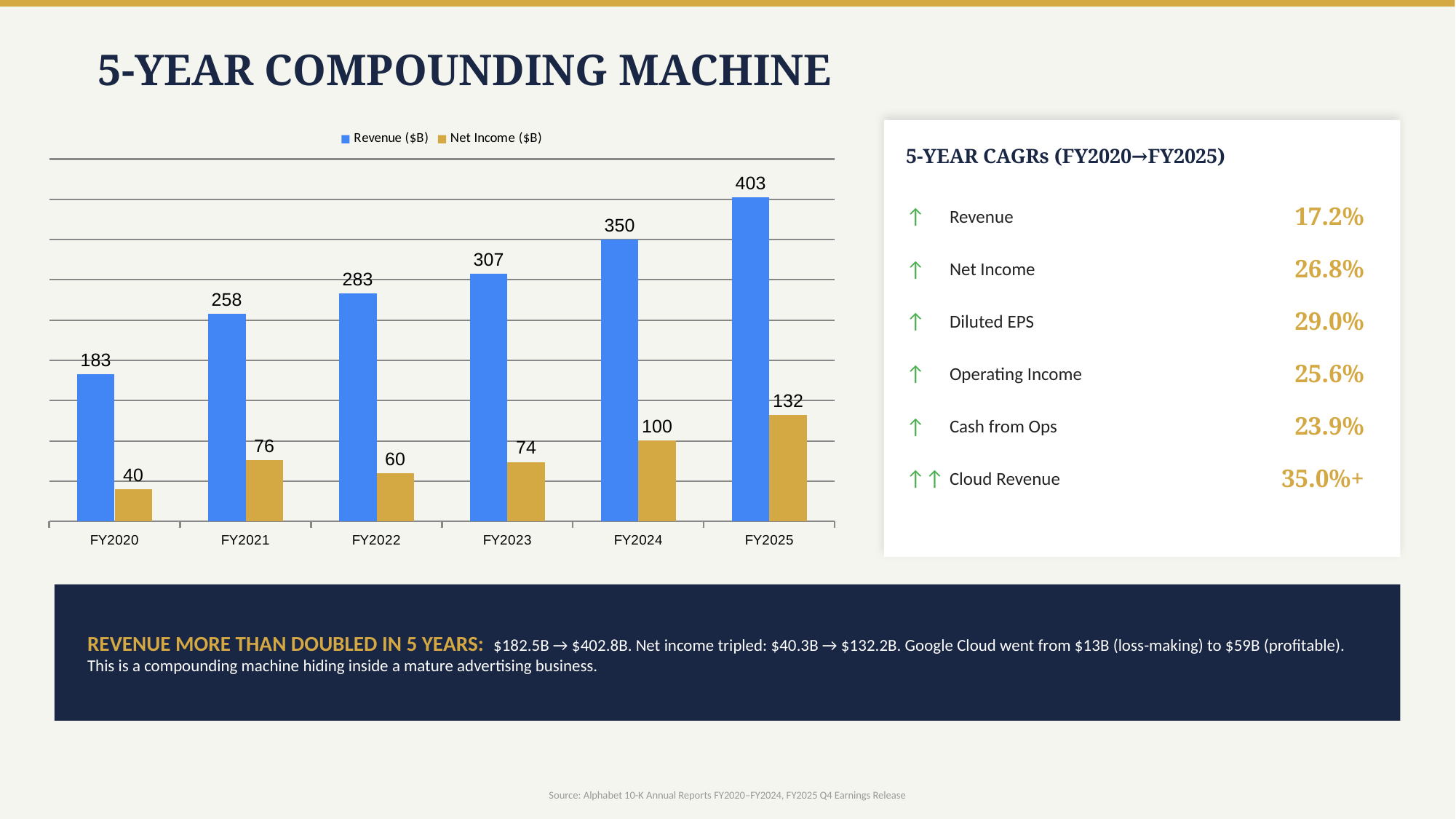
What is the difference between Net Income ($B) in FY2024 and FY2023? 26 What colour are the Net Income ($B) bars in the chart? Gold What is the Revenue ($B) value for FY2023? 307 What is the Net Income ($B) value for FY2021? 76 Which fiscal year has the highest Revenue ($B)? FY2025 What is the difference between Revenue ($B) in FY2025 and FY2020? 220 How many series does the chart legend list? 2 Which is larger: Net Income ($B) in FY2021 or in FY2022? FY2021 What kind of chart is shown on the slide? Bar chart How many fiscal years are shown on the x axis of the chart? 6 Which fiscal year has the lowest Net Income ($B)? FY2020 Does Revenue ($B) rise or fall from FY2020 to FY2025? Rise